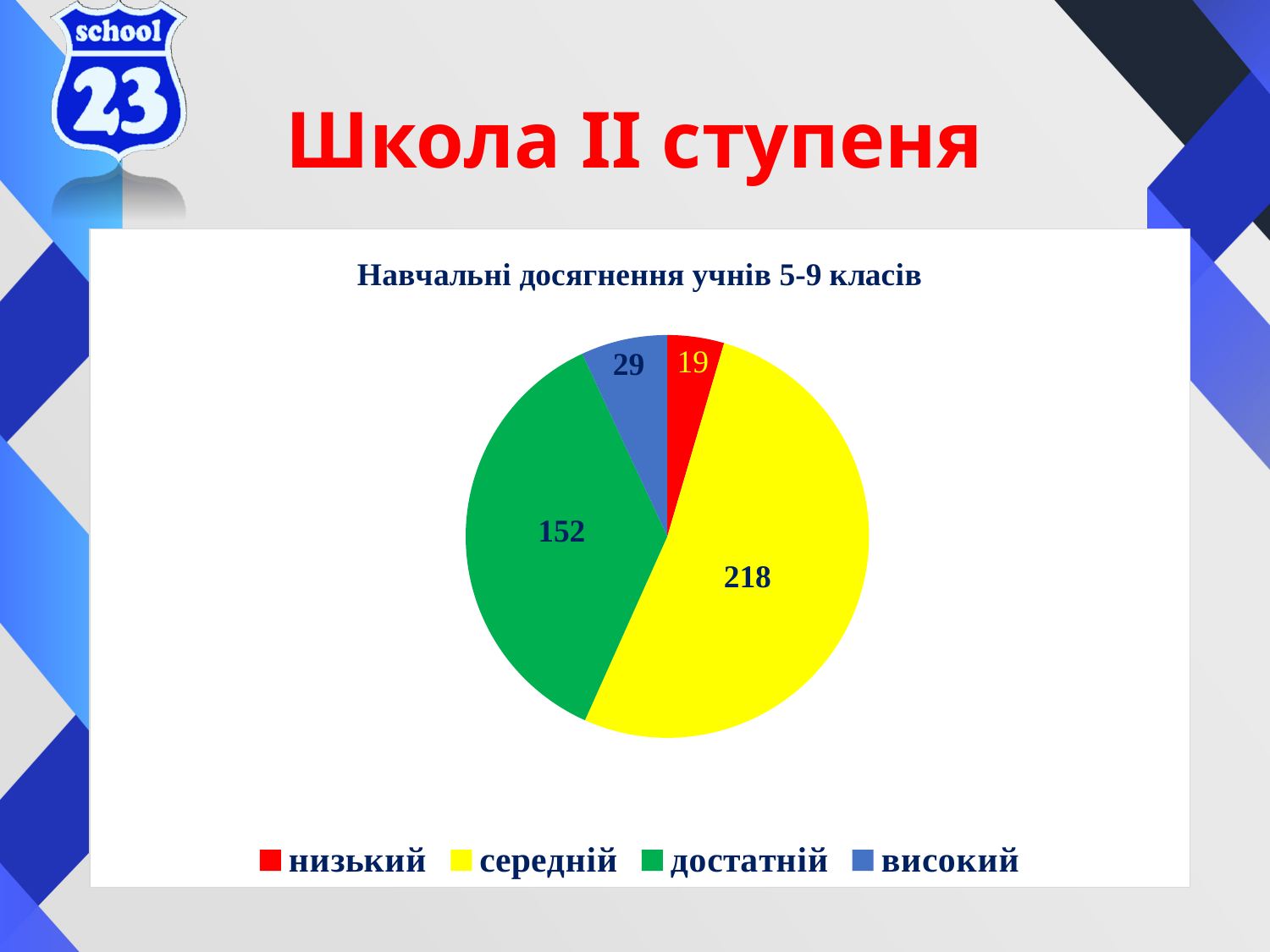
How many slices does the pie chart have? 4 Which category has the smallest slice? низький How many entries does the legend list? 4 Which category has the largest slice? середній What is the title of the chart? Навчальні досягнення учнів 5-9 класів What is the total of all slices in the pie chart? 418 What type of chart is shown on the slide? pie chart What is the value for низький? 19 What is the value for високий? 29 What is the value for достатній? 152 What is the difference between the values for середній and достатній? 66 What is the value for середній? 218